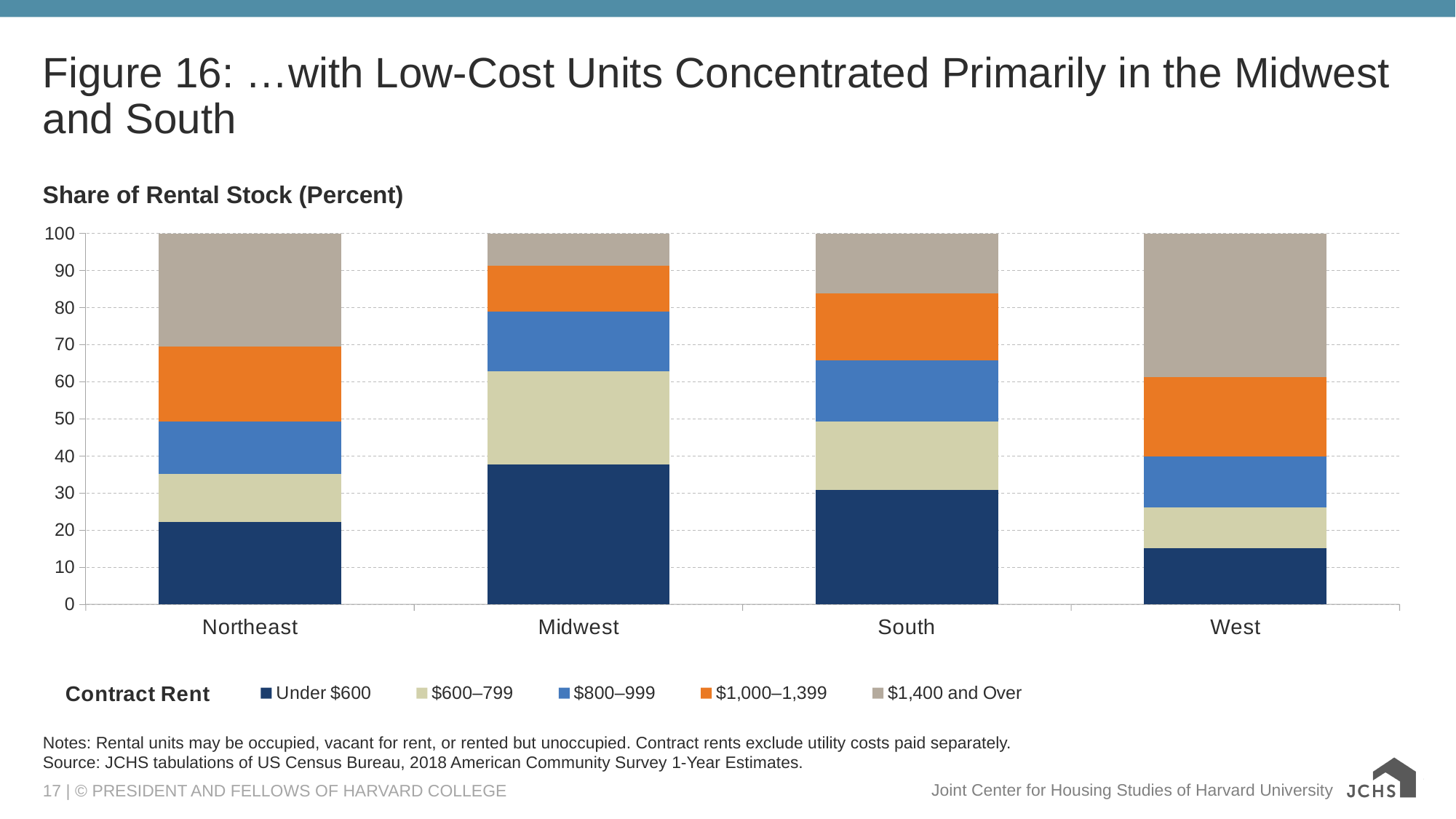
Is the share of rental stock Under $600 in the Midwest greater or less than 30? greater Which region has the largest share of rental stock with contract rent of $1,400 and Over? West Which region has the largest share of rental stock with contract rent Under $600? Midwest Which region has the smallest share of rental stock with contract rent Under $600? West What is the label of the y axis of the chart? Share of Rental Stock (Percent) How many contract rent categories does the legend list? 5 Is the share of rental stock Under $600 in the West greater or less than 20? less Which region has the smallest share of rental stock with contract rent of $1,400 and Over? Midwest How many regions are shown on the x axis of the chart? 4 Which region has a larger share of rental stock Under $600, the South or the West? South What kind of chart is shown on the slide? Stacked bar chart Is the share of rental stock Under $600 in the Northeast greater or less than 30? less